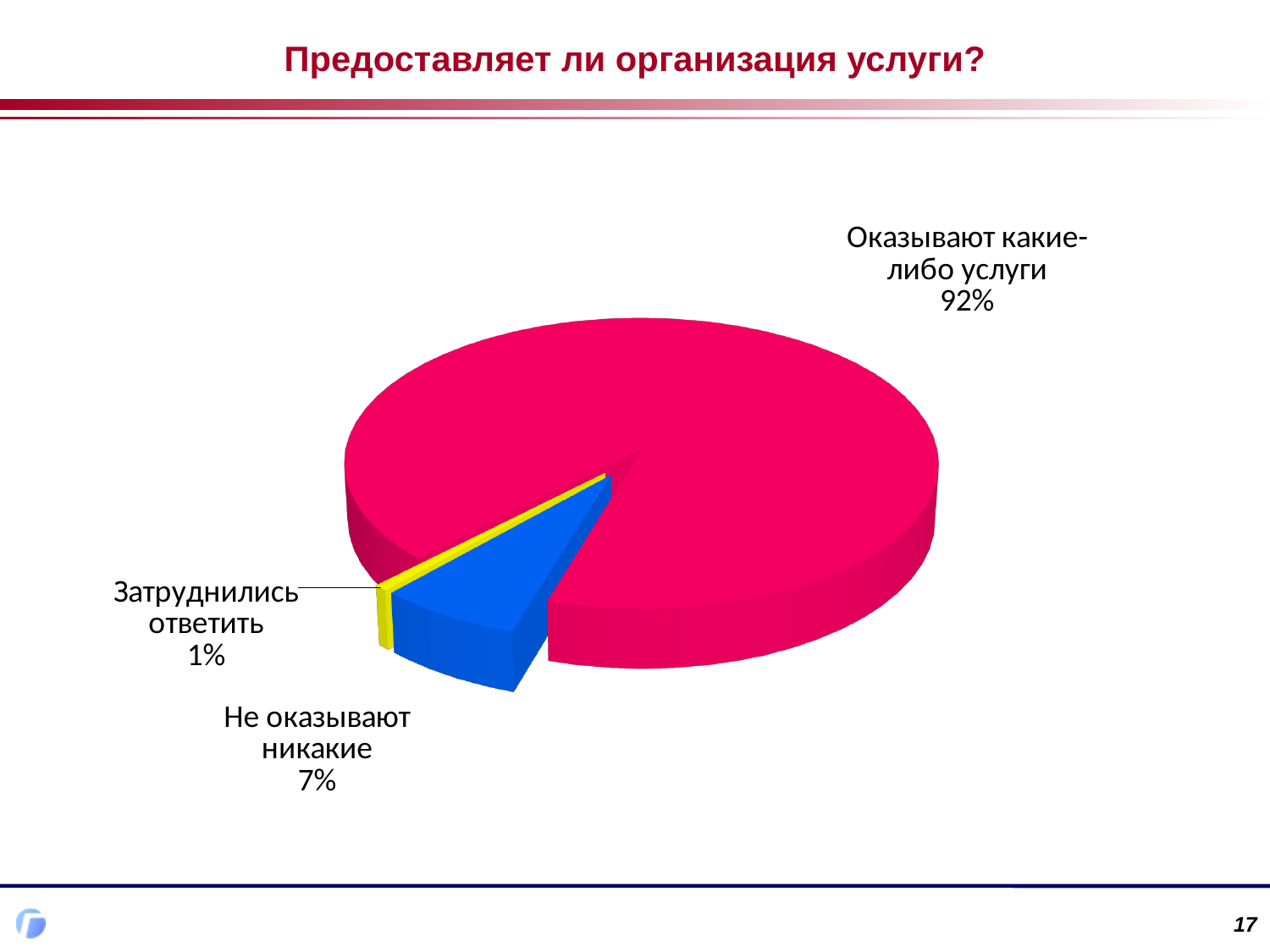
How many slices does the pie chart have? 3 What share of the pie is labelled "Не оказывают никакие"? 7% What is the title of the slide containing the pie chart? Предоставляет ли организация услуги? What share of the pie is labelled "Затруднились ответить"? 1% Which slice of the pie is the smallest? Затруднились ответить Which slice of the pie is the largest? Оказывают какие-либо услуги What share of the pie is labelled "Оказывают какие-либо услуги"? 92% What kind of chart is shown on the slide? pie chart What is the difference in percentage points between "Не оказывают никакие" and "Затруднились ответить"? 6 Which is larger: the share for "Не оказывают никакие" or for "Затруднились ответить"? Не оказывают никакие What colour is the slice for "Не оказывают никакие"? blue What is the difference in percentage points between "Оказывают какие-либо услуги" and "Не оказывают никакие"? 85